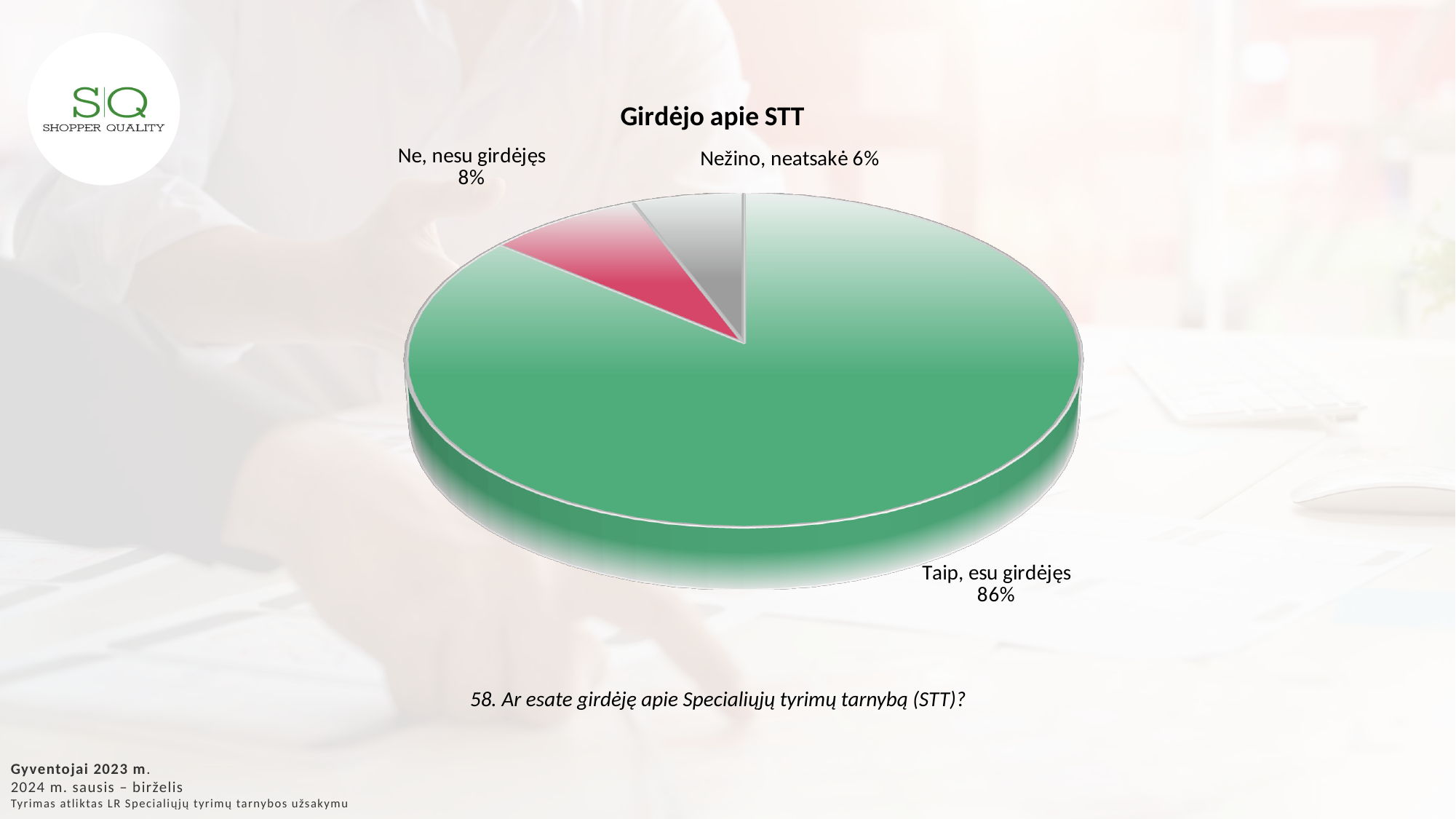
Which category has the largest slice of the pie? Taip, esu girdėjęs What is the difference in percentage points between "Ne, nesu girdėjęs" and "Nežino, neatsakė"? 2 What share of the pie is labelled "Taip, esu girdėjęs"? 86% What is the difference in percentage points between "Taip, esu girdėjęs" and "Ne, nesu girdėjęs"? 78 What share of the pie is labelled "Ne, nesu girdėjęs"? 8% How many slices does the pie chart have? 3 What colour is the slice for "Taip, esu girdėjęs"? green What is the title of the chart? Girdėjo apie STT Which is larger, the slice for "Ne, nesu girdėjęs" or the slice for "Nežino, neatsakė"? Ne, nesu girdėjęs What kind of chart is shown on the slide? pie chart Which category has the smallest slice of the pie? Nežino, neatsakė What share of the pie is labelled "Nežino, neatsakė"? 6%